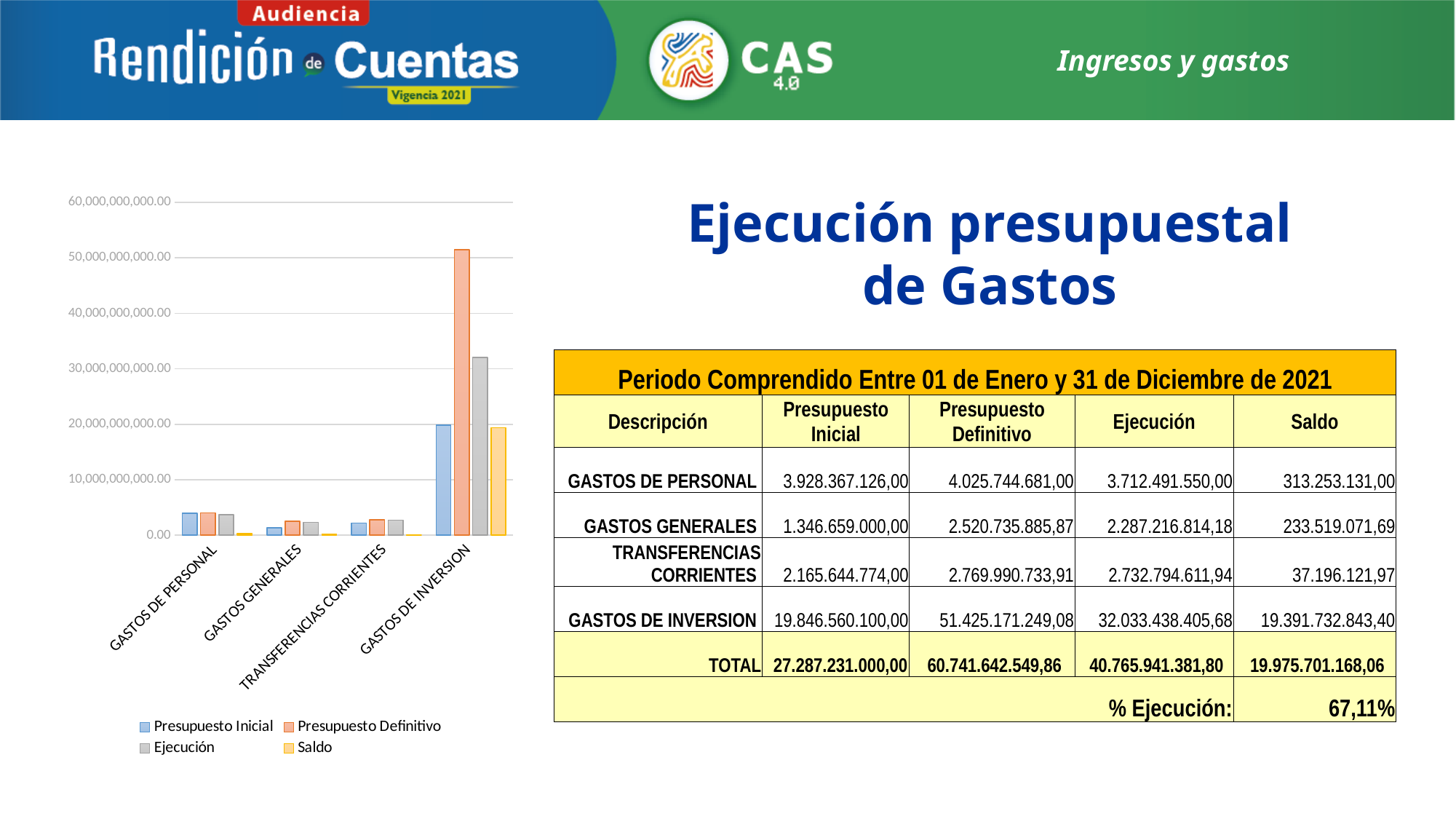
For GASTOS DE INVERSION, which is larger, the Presupuesto Definitivo bar or the Ejecución bar? Presupuesto Definitivo How many categories are shown on the x axis of the bar chart? 4 Which category has the highest Presupuesto Definitivo bar in the chart? GASTOS DE INVERSION Is the Presupuesto Inicial value for GASTOS DE INVERSION greater or less than 10,000,000,000.00? greater Is the Ejecución value for GASTOS DE INVERSION greater or less than 40,000,000,000.00? less According to the table on the slide, what is the Ejecución value for GASTOS DE PERSONAL? 3.712.491.550,00 Which has the larger Presupuesto Inicial bar, GASTOS DE PERSONAL or GASTOS GENERALES? GASTOS DE PERSONAL Is the Presupuesto Definitivo value for GASTOS DE INVERSION greater or less than 40,000,000,000.00? greater What colour represents the Saldo series in the bar chart's legend? yellow How many series does the bar chart's legend list? 4 What kind of chart is shown on the left of the slide? bar chart According to the table on the slide, what is the Saldo value for GASTOS DE INVERSION? 19.391.732.843,40